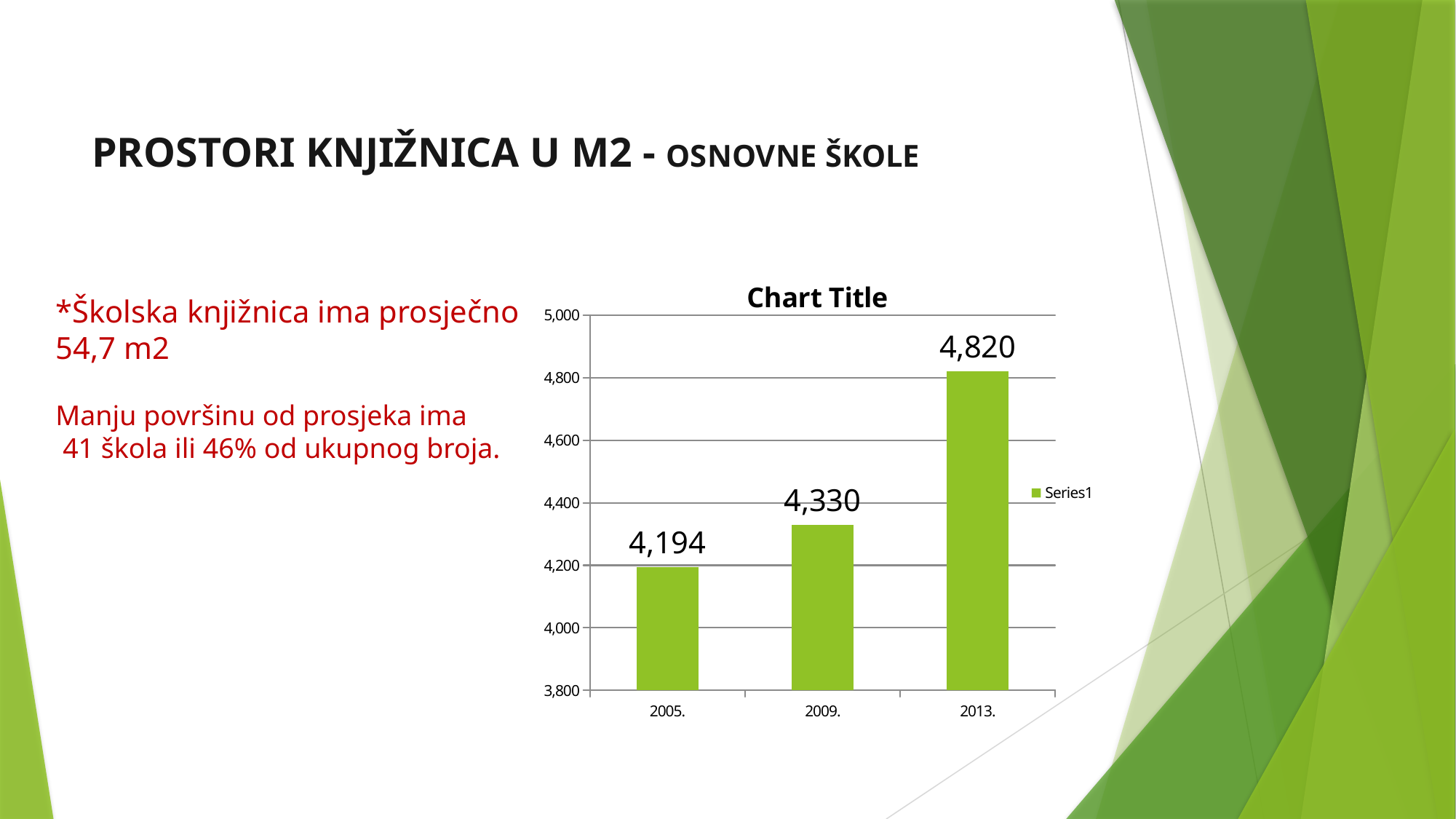
What is the value for 2009.? 4,330 Do the values rise or fall from 2005. to 2013.? rise What is the difference between the values for 2009. and 2005.? 136 What is the difference between the values for 2013. and 2005.? 626 Which year has the lowest value? 2005. Which is larger, the value for 2009. or the value for 2013.? 2013. What is the value for 2013.? 4,820 How many years are shown on the x axis? 3 Which year has the highest value? 2013. What kind of chart is shown on the slide? bar chart Is the value for 2013. greater or less than 4,600? greater What is the value for 2005.? 4,194